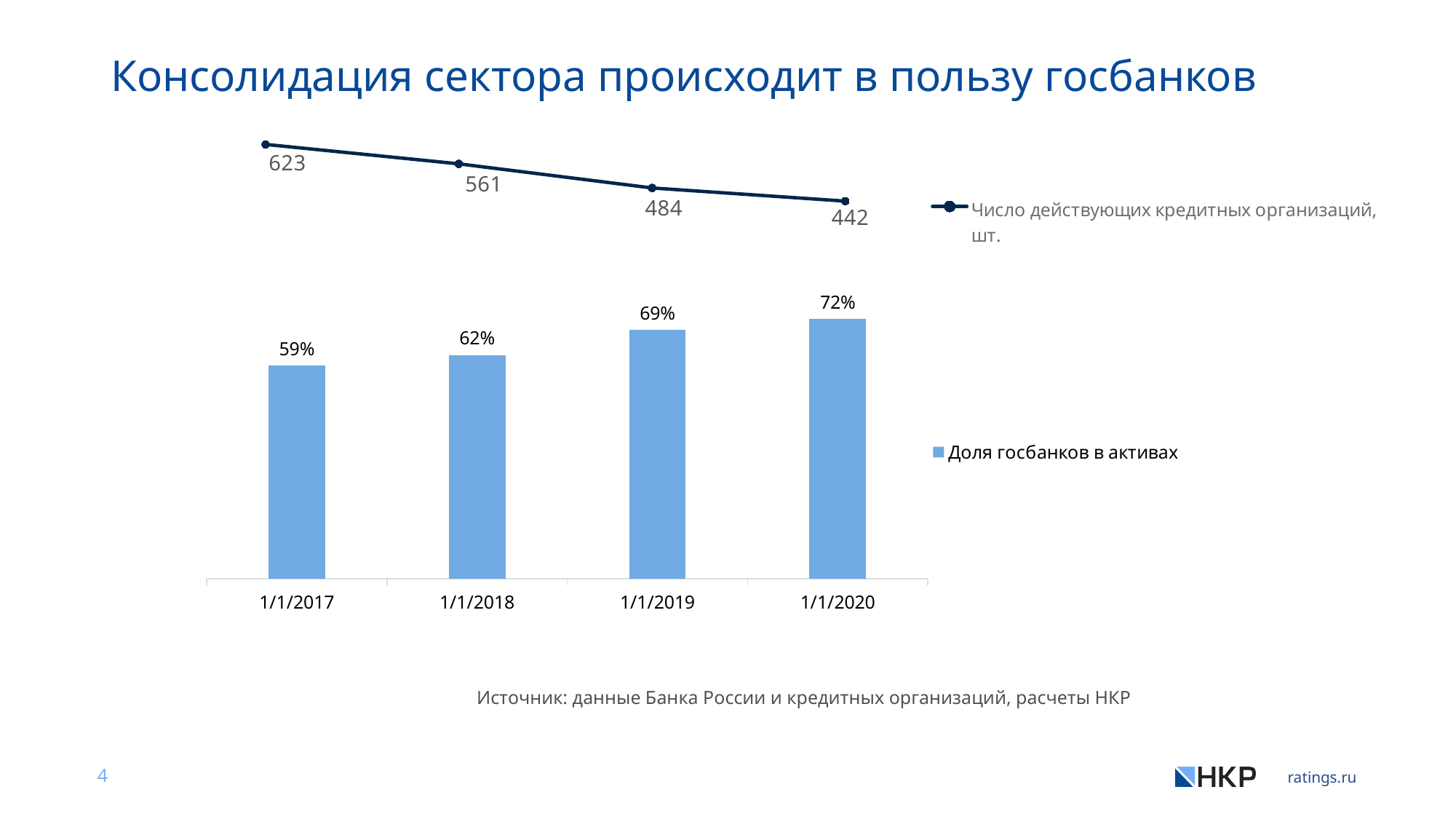
What is the difference in the share of state banks in assets between 1/1/2019 and 1/1/2018? 7% What is the number of operating credit organisations (Число действующих кредитных организаций, шт.) on 1/1/2019? 484 How many dates are shown on the x axis of the chart? 4 What is the share of state banks in assets (Доля госбанков в активах) on 1/1/2017? 59% By how much did the number of operating credit organisations fall from 1/1/2017 to 1/1/2020? 181 On which date is the number of operating credit organisations the lowest? 1/1/2020 How many series does the legend list? 2 Which is larger: the number of operating credit organisations on 1/1/2018 or on 1/1/2019? 1/1/2018 What is the share of state banks in assets on 1/1/2020? 72% What is the title of the slide? Консолидация сектора происходит в пользу госбанков Does the number of operating credit organisations rise or fall from 1/1/2017 to 1/1/2020? fall On which date is the share of state banks in assets the highest? 1/1/2020